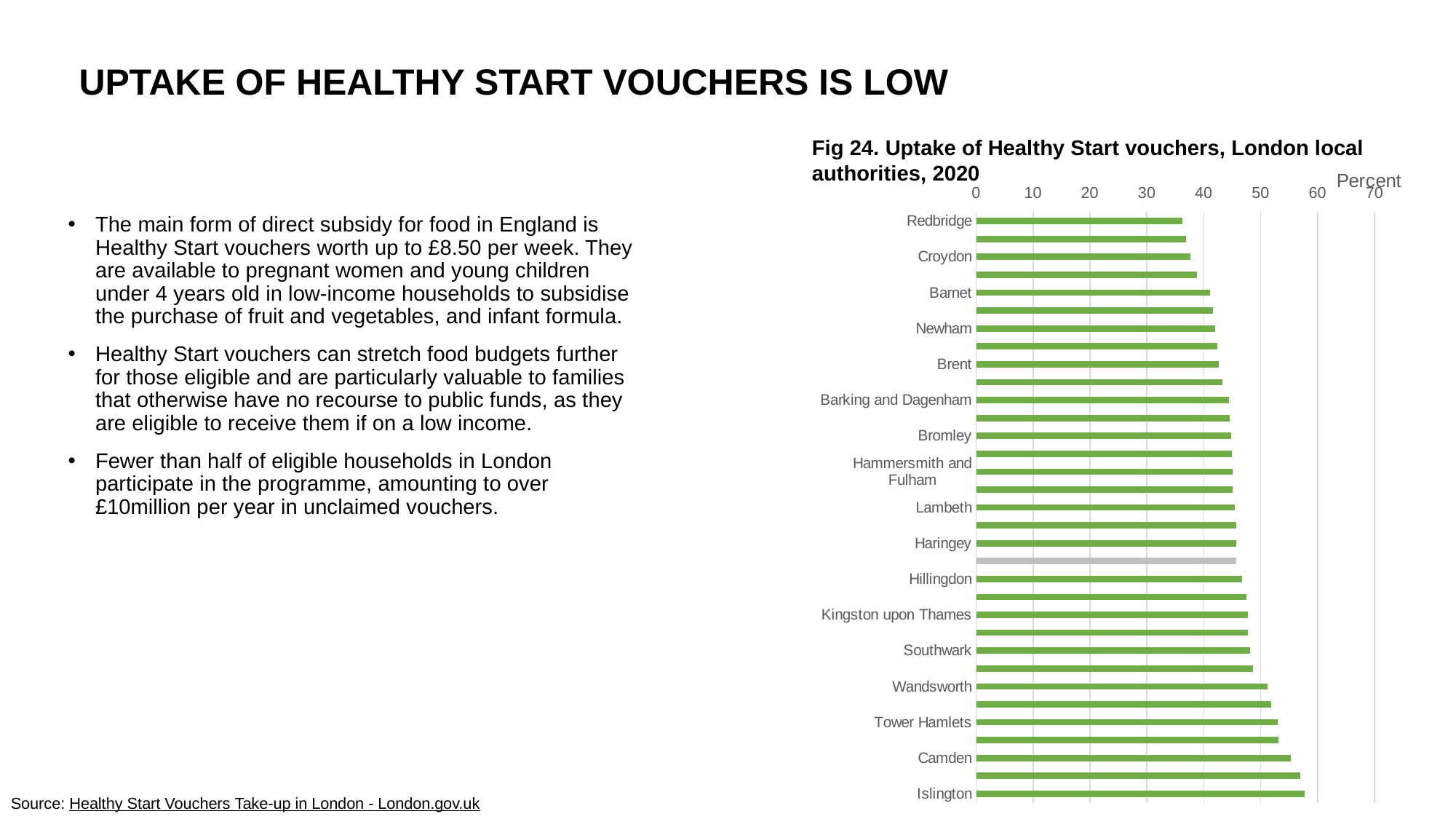
Is the uptake value for Southwark greater or less than 50? less How many bars are plotted in Fig 24? 33 Is the uptake value for Camden greater or less than 50? greater Which has a lower uptake of Healthy Start vouchers, Croydon or Camden? Croydon What unit is shown on the horizontal axis of Fig 24? Percent Which labelled local authority has the highest uptake of Healthy Start vouchers in Fig 24? Islington What kind of chart is shown in Fig 24? bar chart Is the uptake value for Islington greater or less than 50? greater Which labelled local authority has the lowest uptake of Healthy Start vouchers in Fig 24? Redbridge Which has a higher uptake of Healthy Start vouchers, Tower Hamlets or Bromley? Tower Hamlets